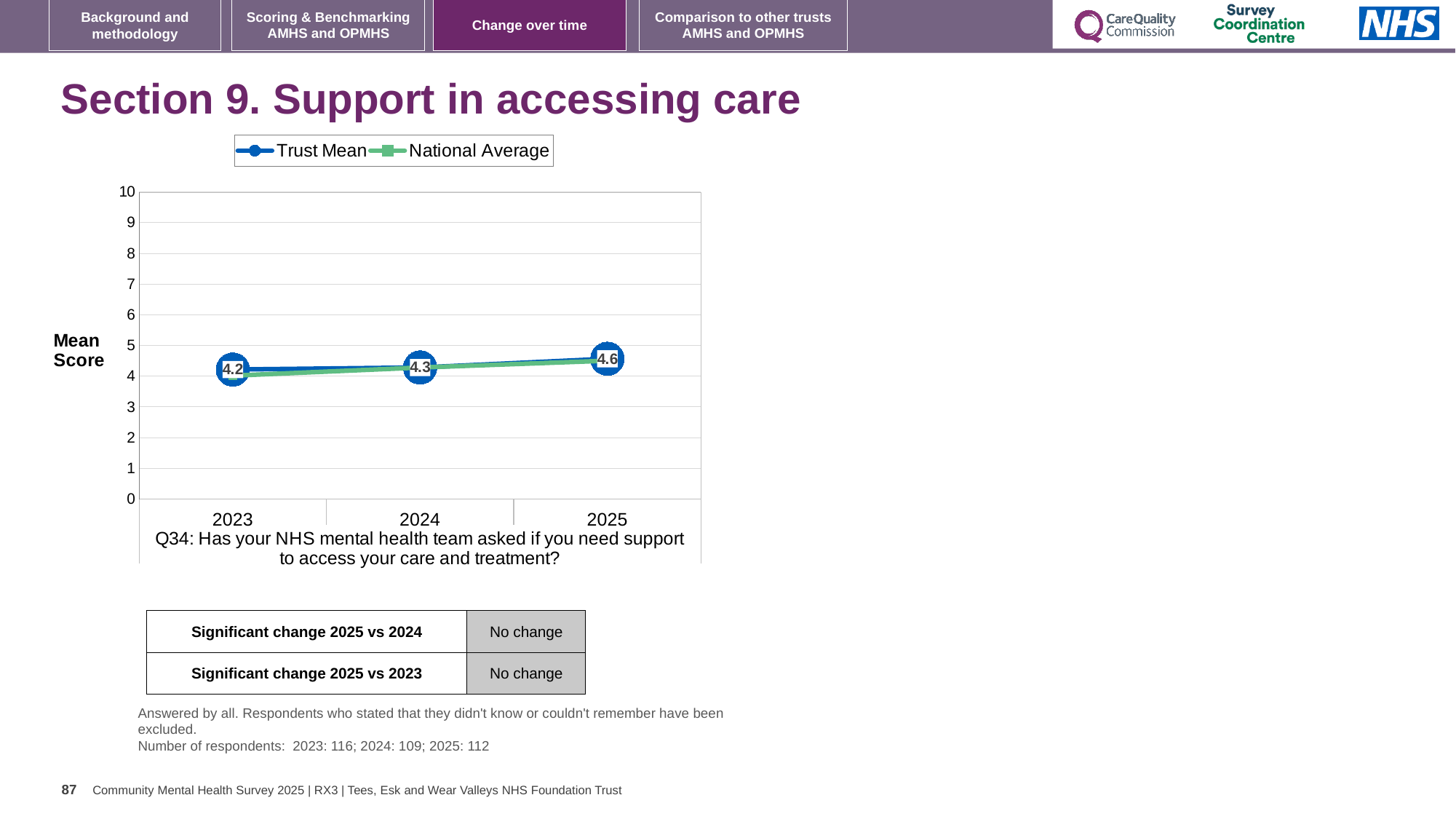
What is the Trust Mean score for 2025? 4.6 By how much did the Trust Mean score change from 2023 to 2025? 0.4 In which year is the Trust Mean score highest? 2025 What is the Trust Mean score for 2023? 4.2 What are the two series named in the legend? Trust Mean and National Average Does the Trust Mean score rise or fall from 2023 to 2025? rise What kind of chart is shown on the slide? line chart What is the Trust Mean score for 2024? 4.3 How many series does the legend list? 2 How many years are plotted on the x axis? 3 In which year is the Trust Mean score lowest? 2023 Is the Trust Mean score for 2025 greater or less than 5? less